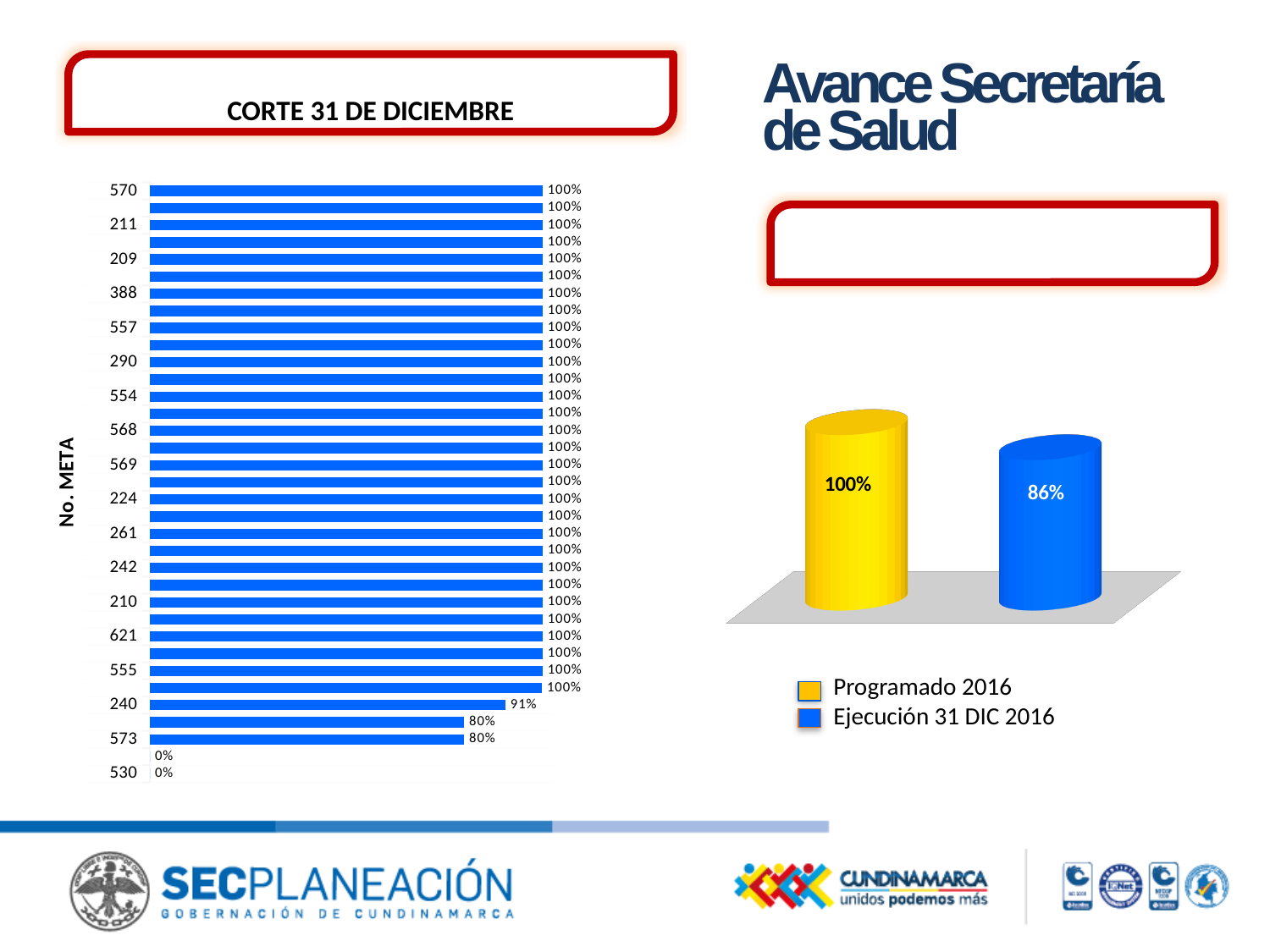
In the left bar chart, which has the larger value, meta 240 or meta 573? 240 In the left bar chart, what is the difference between the values for meta 240 and meta 573? 11% How many entries does the legend of the right chart (Avance Secretaría de Salud) list? 2 In the left bar chart, what is the title of the vertical axis? No. META In the left bar chart, what is the value shown for meta 530? 0% In the left bar chart, what is the value shown for meta 573? 80% What kind of chart is the right chart (Avance Secretaría de Salud)? Bar chart In the left bar chart, what is the value shown for meta 570? 100% In the right chart (Avance Secretaría de Salud), what is the value for Programado 2016? 100% In the right chart (Avance Secretaría de Salud), what is the value for Ejecución 31 DIC 2016? 86% In the right chart (Avance Secretaría de Salud), what is the difference between Programado 2016 and Ejecución 31 DIC 2016? 14% In the left bar chart, what is the value shown for meta 240? 91%